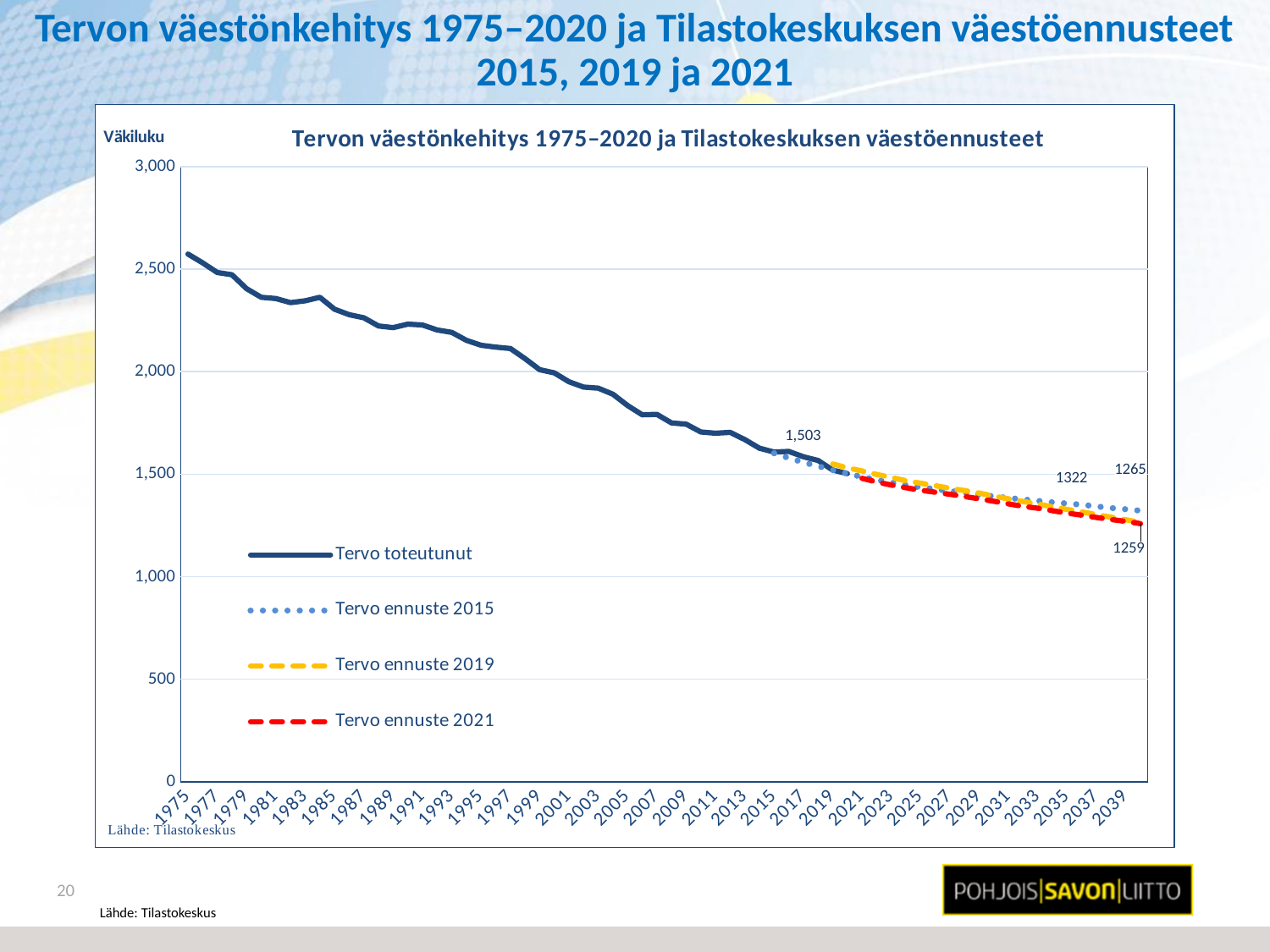
Does the Tervo toteutunut line rise or fall from 1975 to 2020? fall What is the final labelled value of the Tervo ennuste 2021 series? 1259 Is the value of Tervo toteutunut in 2005 greater or less than 2,000? less Is the value of Tervo toteutunut in 1975 greater or less than 2,500? greater What is the final labelled value of the Tervo ennuste 2015 series? 1322 Which series ends at a higher value at the right end of the chart, Tervo ennuste 2015 or Tervo ennuste 2021? Tervo ennuste 2015 What kind of chart is shown on the slide? line chart What is the difference between the final labelled values of Tervo ennuste 2019 (1265) and Tervo ennuste 2021 (1259)? 6 Is the value of Tervo toteutunut in 1985 greater or less than 2,500? less How many series does the chart legend list? 4 What label is shown on the vertical axis of the chart? Väkiluku Which series are listed in the chart legend? Tervo toteutunut, Tervo ennuste 2015, Tervo ennuste 2019, Tervo ennuste 2021